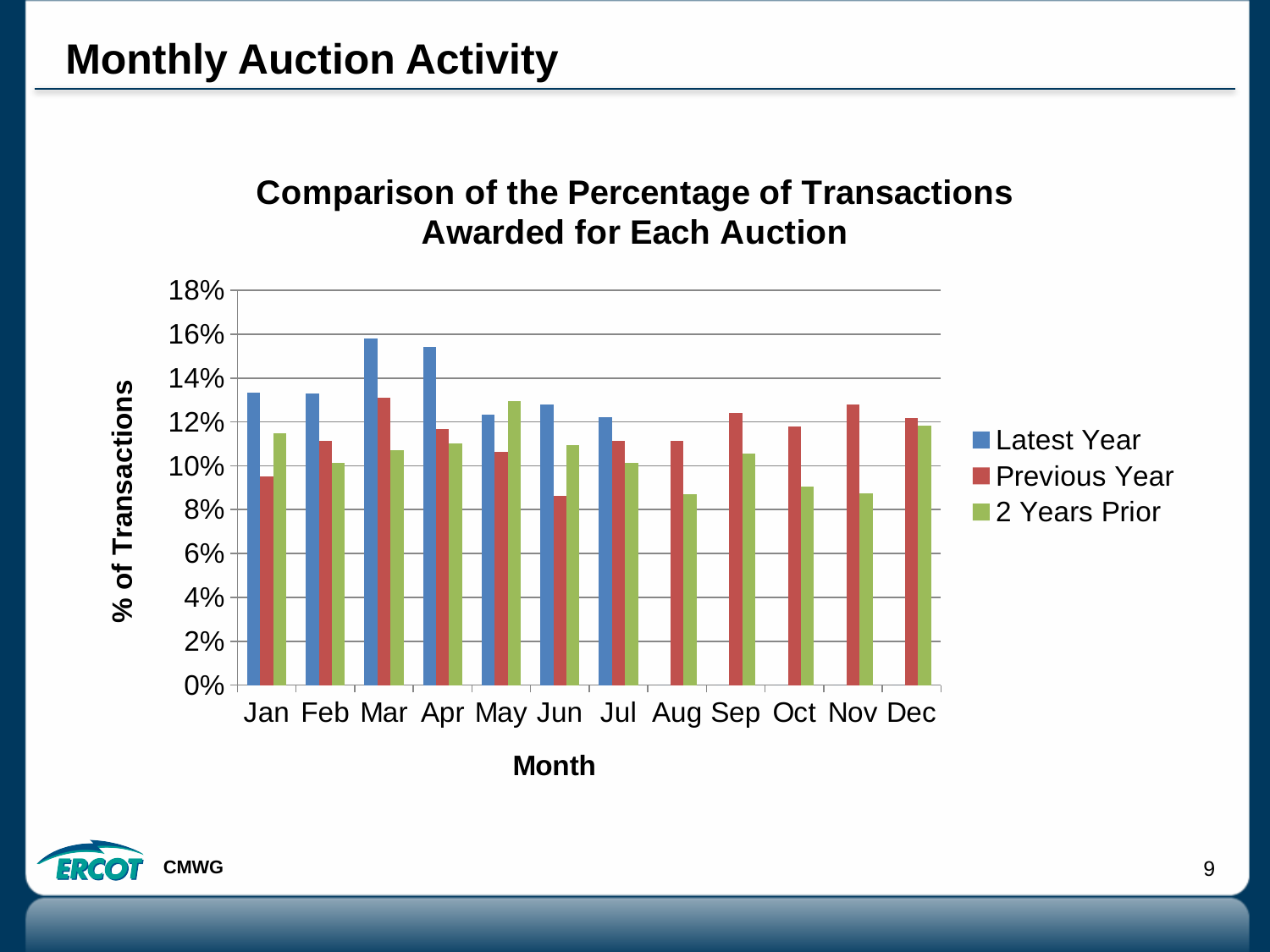
In which month is the Latest Year value highest? Mar Is the Latest Year value for Mar greater or less than 14%? greater Is the Previous Year value for Jan greater or less than 10%? less What is the title of the y axis? % of Transactions What kind of chart is shown on the slide? Bar chart Which series has no bars for Aug through Dec? Latest Year How many months are shown on the x axis? 12 In Jan, which is larger: Latest Year or Previous Year? Latest Year In May, which is larger: Previous Year or 2 Years Prior? 2 Years Prior In which month is the 2 Years Prior value highest? May In which month is the Previous Year value lowest? Jun How many series does the legend list? 3